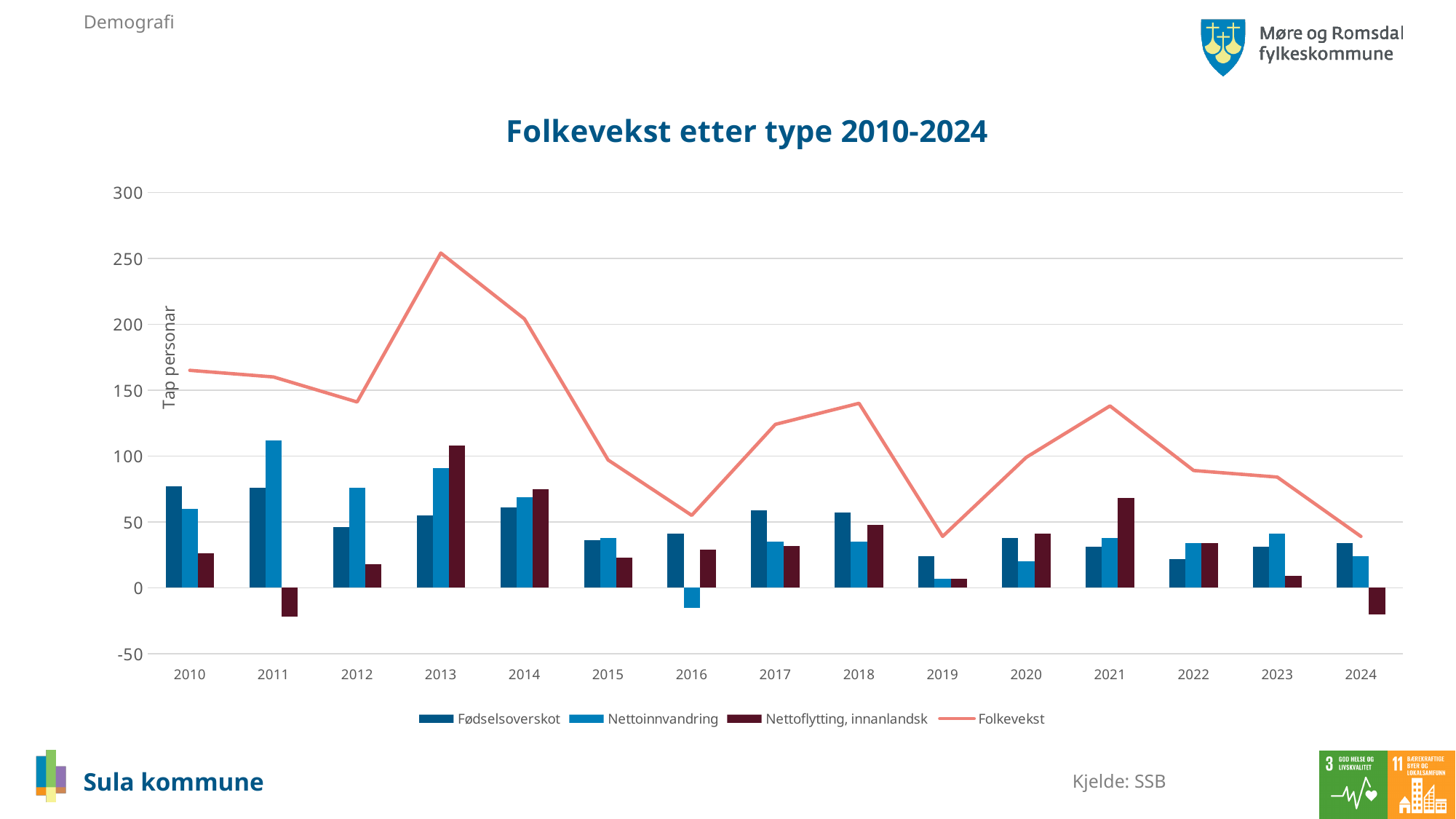
How many years are shown on the x axis? 15 Is the Nettoinnvandring value for 2011 greater or less than 100? greater What kind of chart is shown on the slide? A bar chart combined with a line In which year is the Nettoinnvandring bar negative? 2016 In which year is the Nettoflytting, innanlandsk bar the tallest? 2013 Is the Folkevekst value for 2013 greater or less than 200? greater In which year does the Folkevekst line reach its highest value? 2013 Does the Folkevekst line rise or fall from 2021 to 2024? Falls In 2011, which is larger: Fødselsoverskot or Nettoinnvandring? Nettoinnvandring Is the Folkevekst value for 2016 greater or less than 100? less In which year is the Nettoinnvandring bar the tallest? 2011 How many series does the legend list? 4